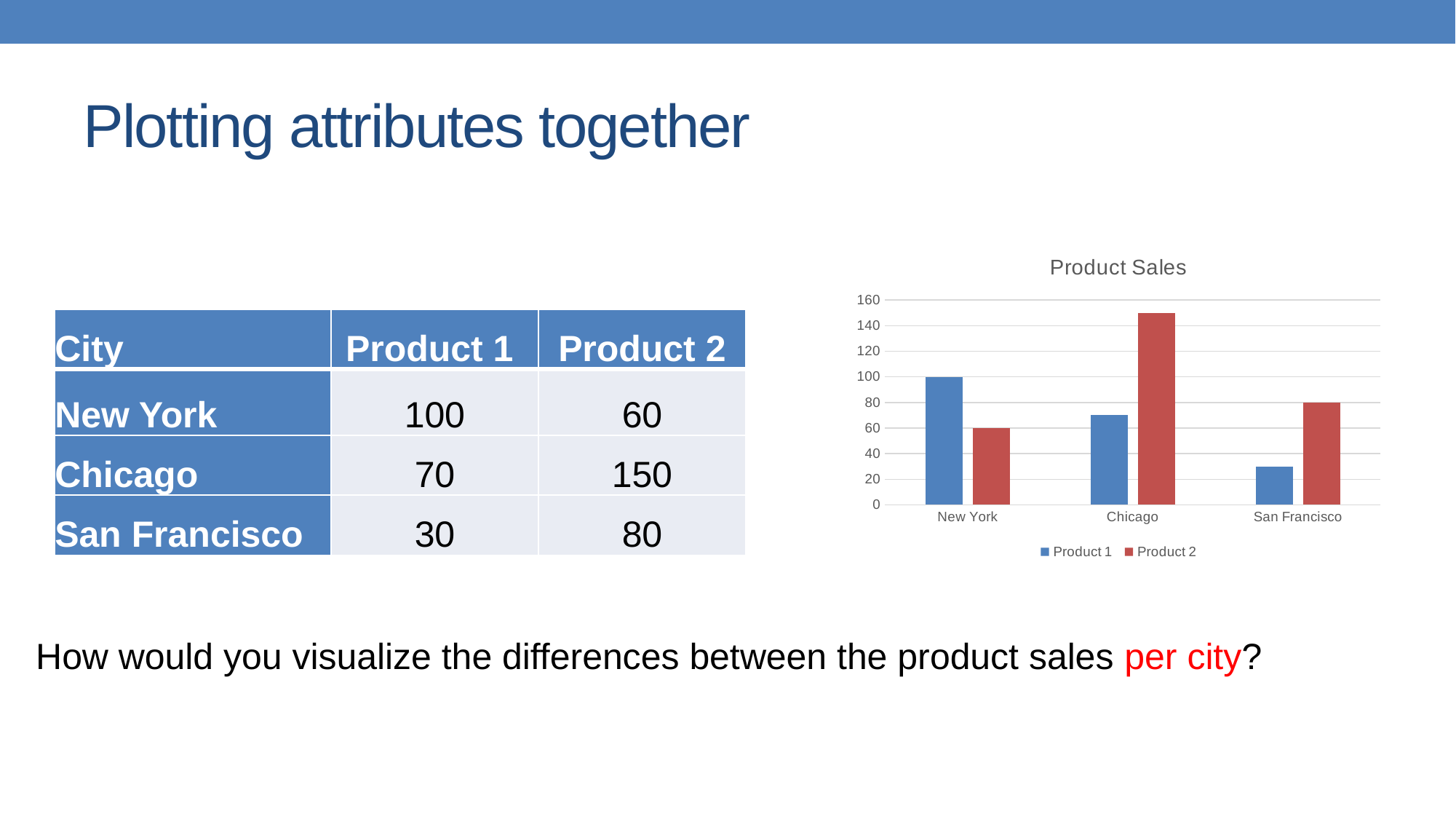
How many series does the legend of the Product Sales chart list? 2 Which city has the highest Product 2 value in the Product Sales chart? Chicago What is the Product 2 value for Chicago in the Product Sales chart? 150 What kind of chart is the Product Sales chart? bar chart In the Product Sales chart, which is larger for New York: Product 1 or Product 2? Product 1 What is the Product 1 value for San Francisco in the Product Sales chart? 30 What is the Product 1 value for New York in the Product Sales chart? 100 Which city has the lowest Product 1 value in the Product Sales chart? San Francisco How many cities are shown on the x axis of the Product Sales chart? 3 What colour are the Product 2 bars in the Product Sales chart? red Is the Product 2 value for Chicago in the Product Sales chart greater or less than 140? greater In the Product Sales chart, what is the difference between Product 2 and Product 1 for Chicago? 80